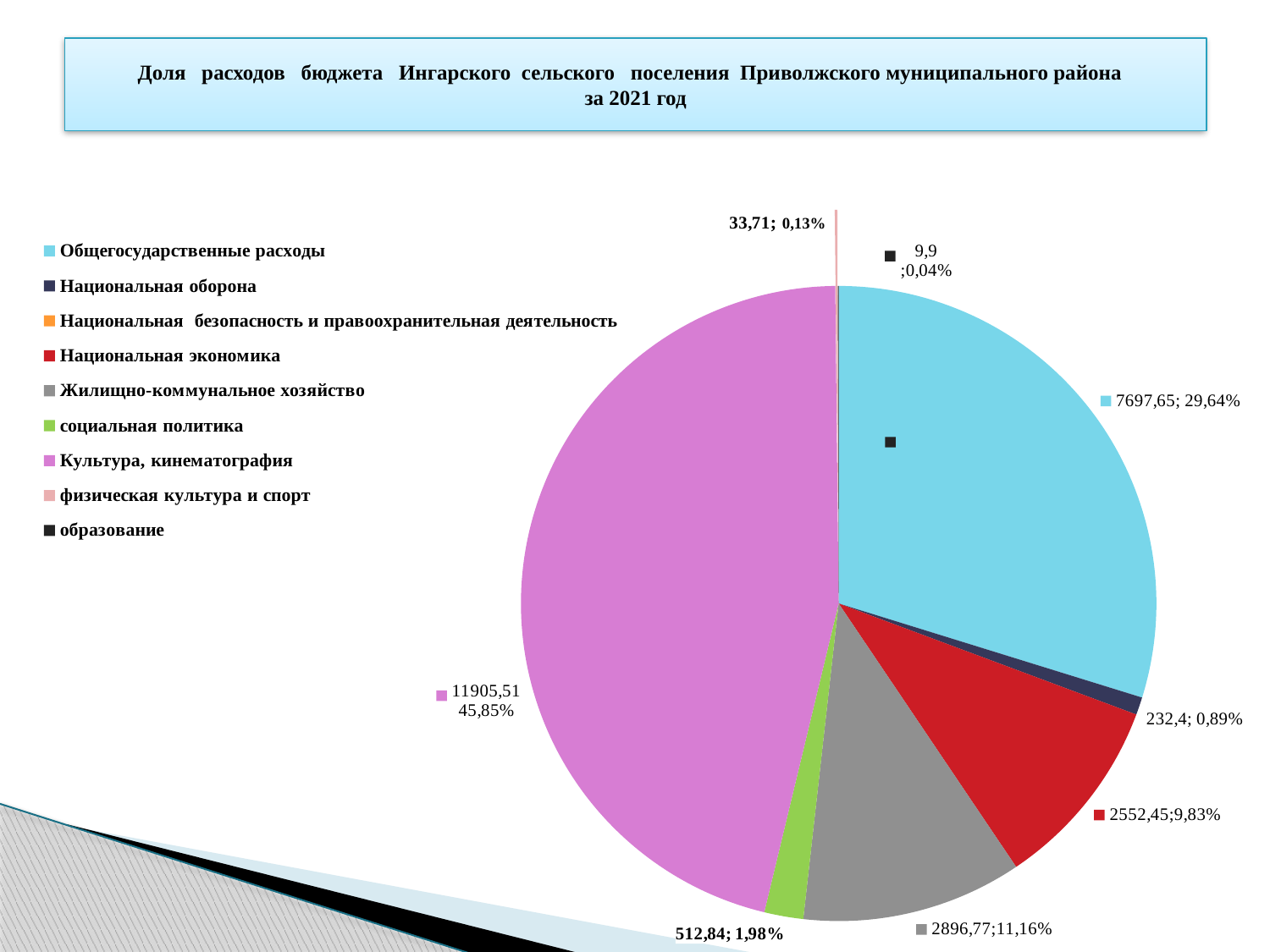
Which labelled category has the smallest slice of the pie? образование Which is larger: the value for Национальная экономика or the value for Жилищно-коммунальное хозяйство? Жилищно-коммунальное хозяйство What value is shown for Культура, кинематография? 11905,51 How many categories does the legend of the pie chart list? 9 What share of the pie does Общегосударственные расходы take? 29,64% What is the difference between the values for Культура, кинематография and Общегосударственные расходы? 4207,86 What is the title of the slide? Доля расходов бюджета Ингарского сельского поселения Приволжского муниципального района за 2021 год What share of the pie does Национальная экономика take? 9,83% What kind of chart is shown on the slide? pie chart Which category has the largest slice of the pie? Культура, кинематография What share of the pie does социальная политика take? 1,98% What value is shown for Жилищно-коммунальное хозяйство? 2896,77